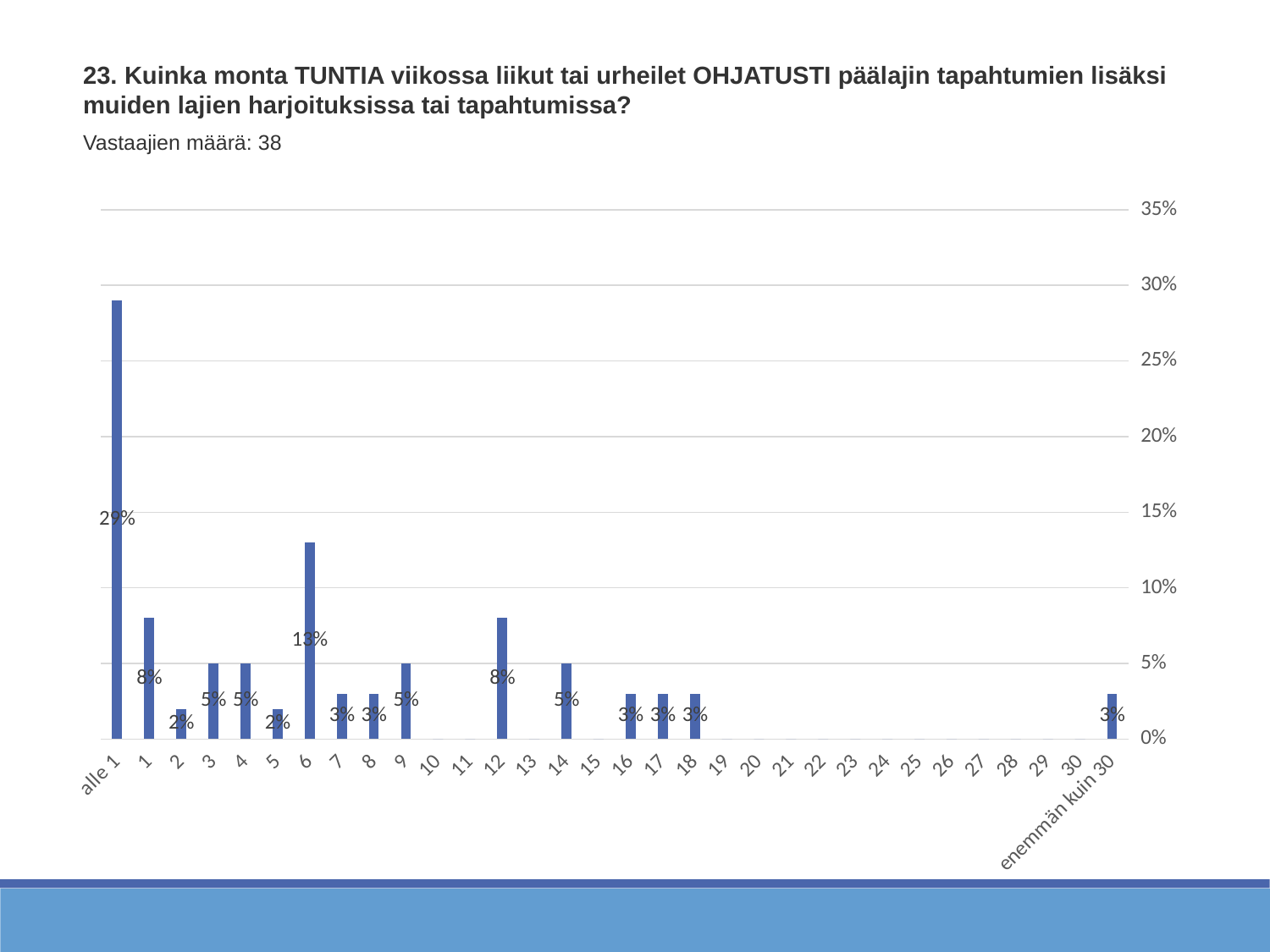
What is the value for the category 6? 13% Is the value for "alle 1" greater or less than 25%? greater What is the difference between the values for 1 and 2? 6% What is the difference between the values for "alle 1" and 6? 16% What kind of chart is shown on the slide? bar chart What is the value for the category "alle 1"? 29% What is the value for the category "enemmän kuin 30"? 3% Which is larger, the value for 6 or the value for 12? 6 How many respondents does the slide report (Vastaajien määrä)? 38 What is the value for the category 12? 8% Which category has the highest value? alle 1 How many categories are shown on the x axis? 32